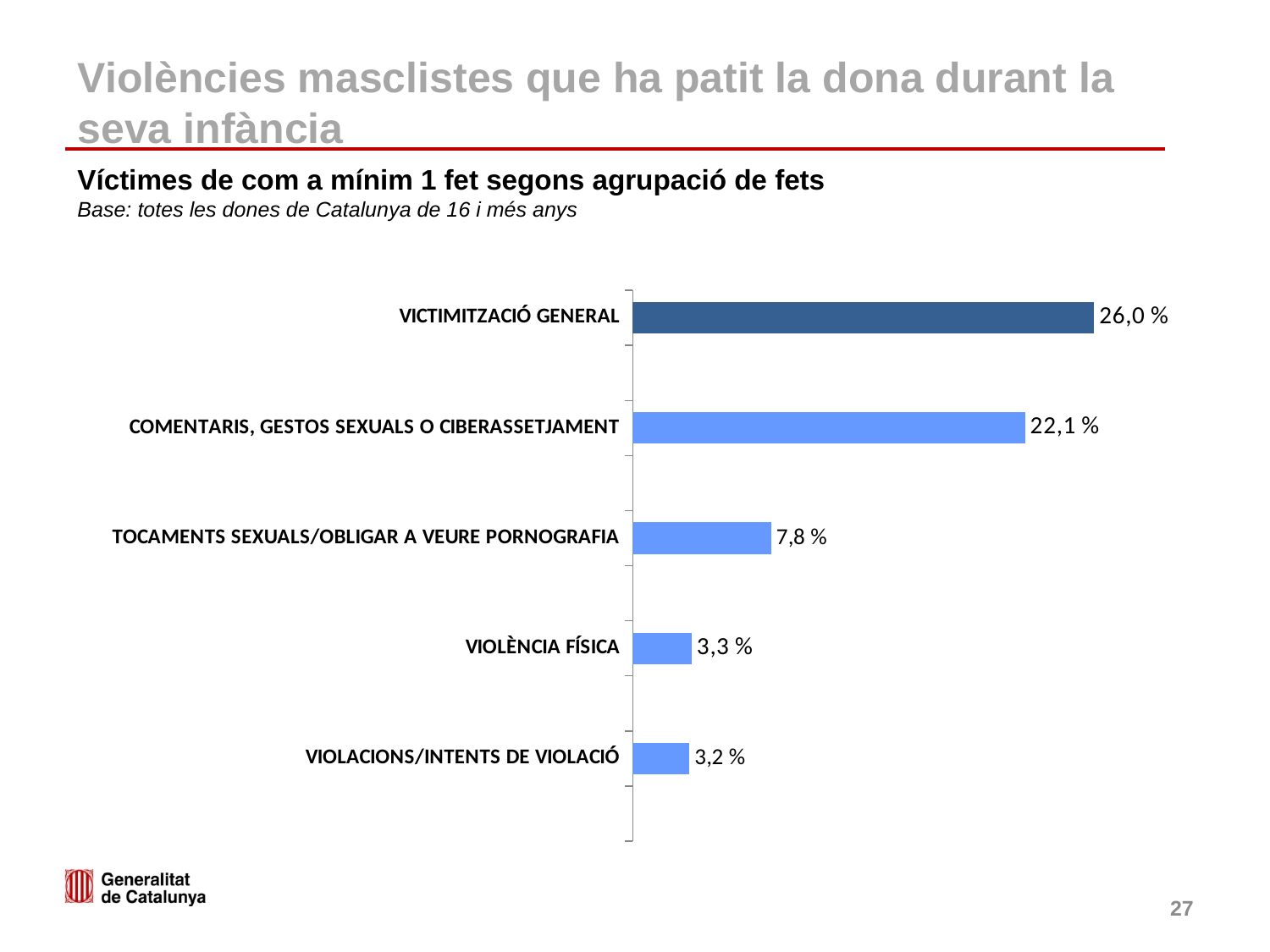
What is the value for VICTIMITZACIÓ GENERAL? 26,0 % What kind of chart is shown on the slide? Bar chart What is the value for VIOLÈNCIA FÍSICA? 3,3 % How many categories are shown in the chart? 5 What is the value for TOCAMENTS SEXUALS/OBLIGAR A VEURE PORNOGRAFIA? 7,8 % What is the title of the chart? Víctimes de com a mínim 1 fet segons agrupació de fets What is the value for VIOLACIONS/INTENTS DE VIOLACIÓ? 3,2 % What is the difference between COMENTARIS, GESTOS SEXUALS O CIBERASSETJAMENT and TOCAMENTS SEXUALS/OBLIGAR A VEURE PORNOGRAFIA? 14,3 % What is the difference between VICTIMITZACIÓ GENERAL and COMENTARIS, GESTOS SEXUALS O CIBERASSETJAMENT? 3,9 % Which category has the highest value? VICTIMITZACIÓ GENERAL Which is larger, TOCAMENTS SEXUALS/OBLIGAR A VEURE PORNOGRAFIA or VIOLÈNCIA FÍSICA? TOCAMENTS SEXUALS/OBLIGAR A VEURE PORNOGRAFIA What is the value for COMENTARIS, GESTOS SEXUALS O CIBERASSETJAMENT? 22,1 %